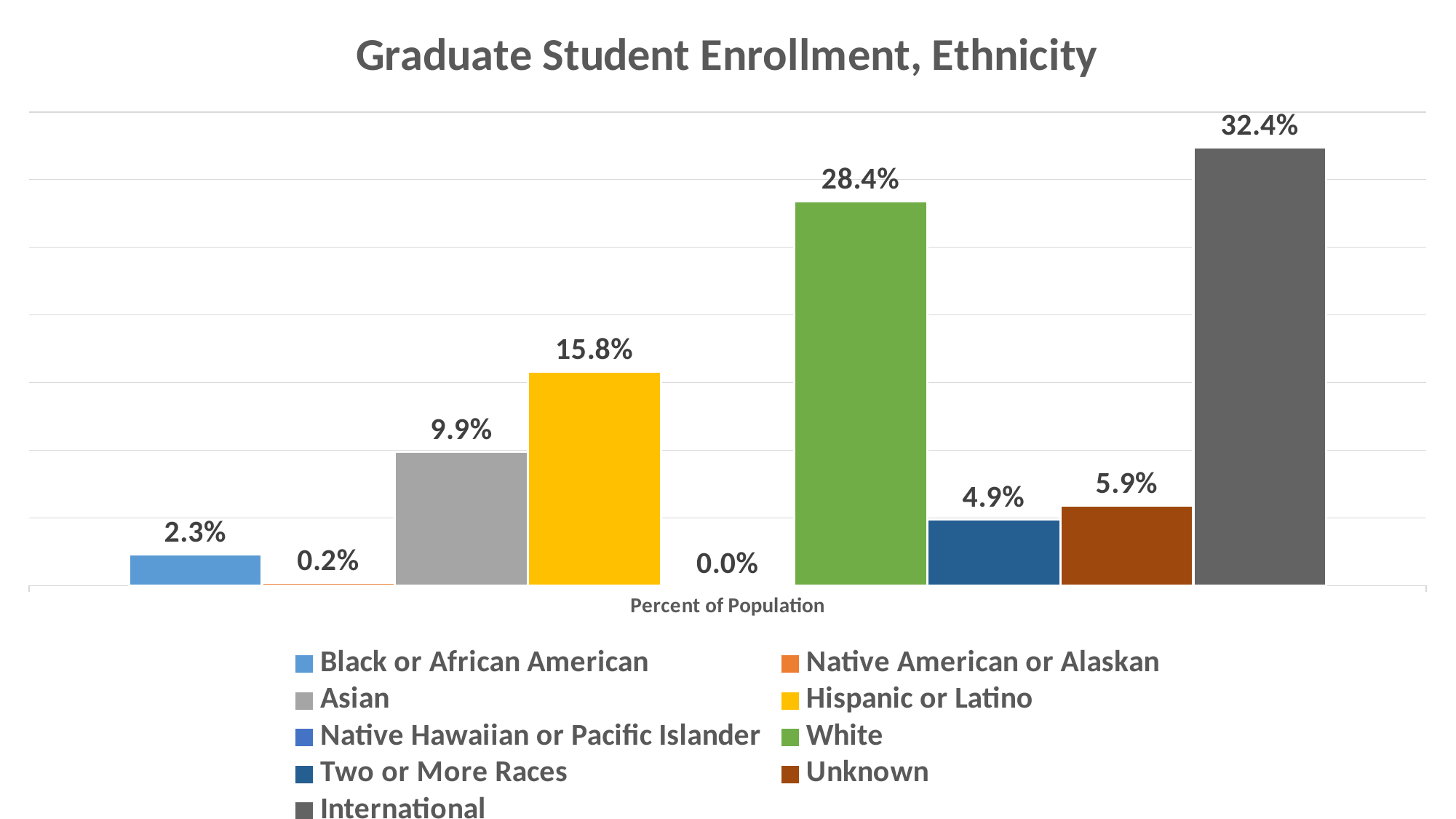
Which group has the lowest value? Native Hawaiian or Pacific Islander What is the title of the chart? Graduate Student Enrollment, Ethnicity What is the difference between the values for International and White? 4.0% What is the value for Hispanic or Latino? 15.8% What is the value for Asian? 9.9% Which is larger, the value for Unknown or the value for Two or More Races? Unknown How many series does the legend list? 9 What kind of chart is this? Bar chart What is the difference between the values for Hispanic or Latino and Asian? 5.9% Which group has the highest value? International What is the value for Native Hawaiian or Pacific Islander? 0.0% What is the value for International? 32.4%